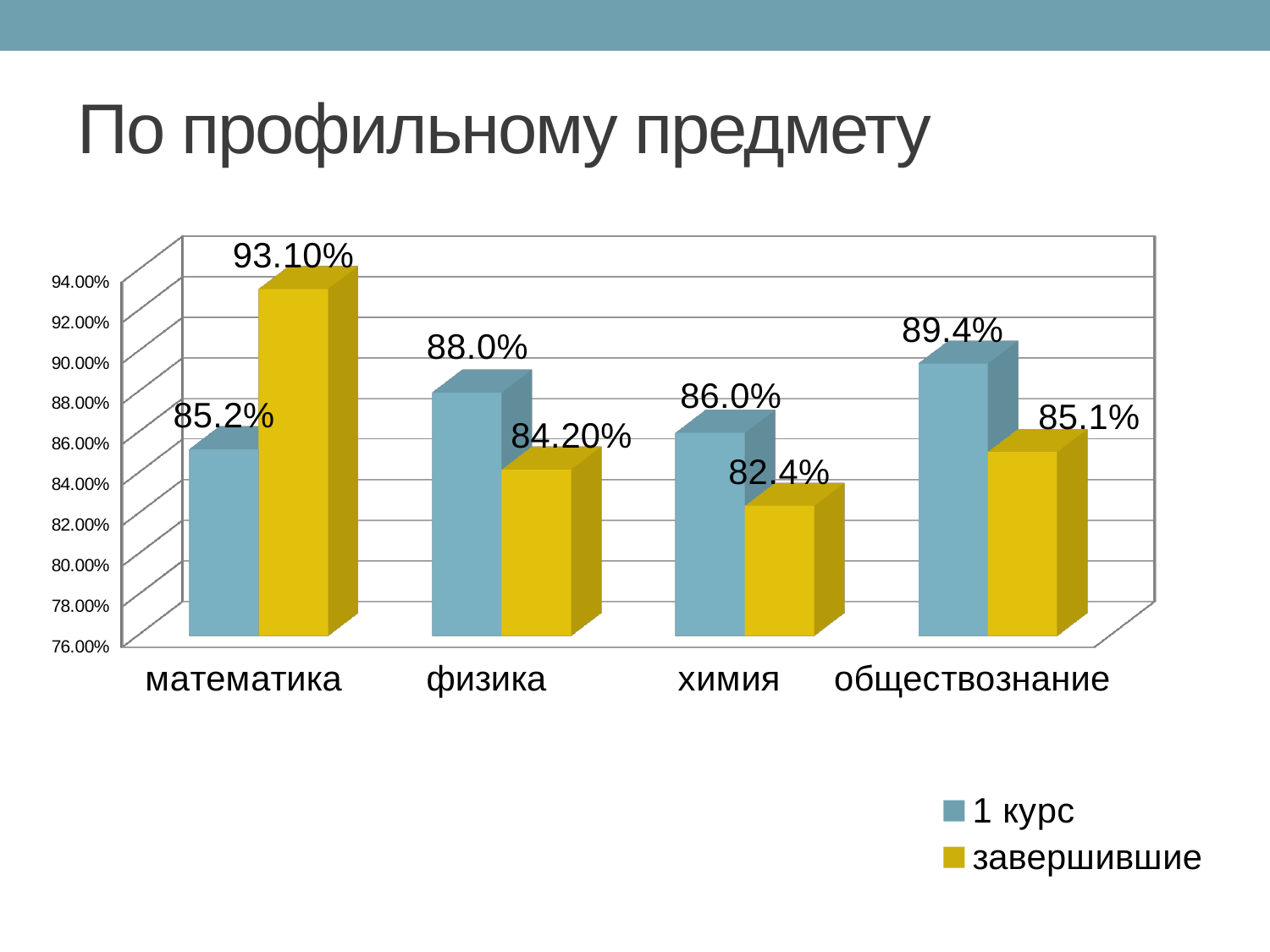
What is the value for 1 курс in обществознание? 89.4% What is the difference between 1 курс and завершившие in химия? 3.6% How many categories are shown on the x axis? 4 What kind of chart is shown on the slide? bar chart What is the value for завершившие in математика? 93.10% Which category has the lowest value for 1 курс? математика Which is larger in физика: 1 курс or завершившие? 1 курс Which category has the highest value for завершившие? математика What is the value for завершившие in физика? 84.20% How many series does the legend list? 2 Which category has the lowest value for завершившие? химия What is the value for 1 курс in математика? 85.2%